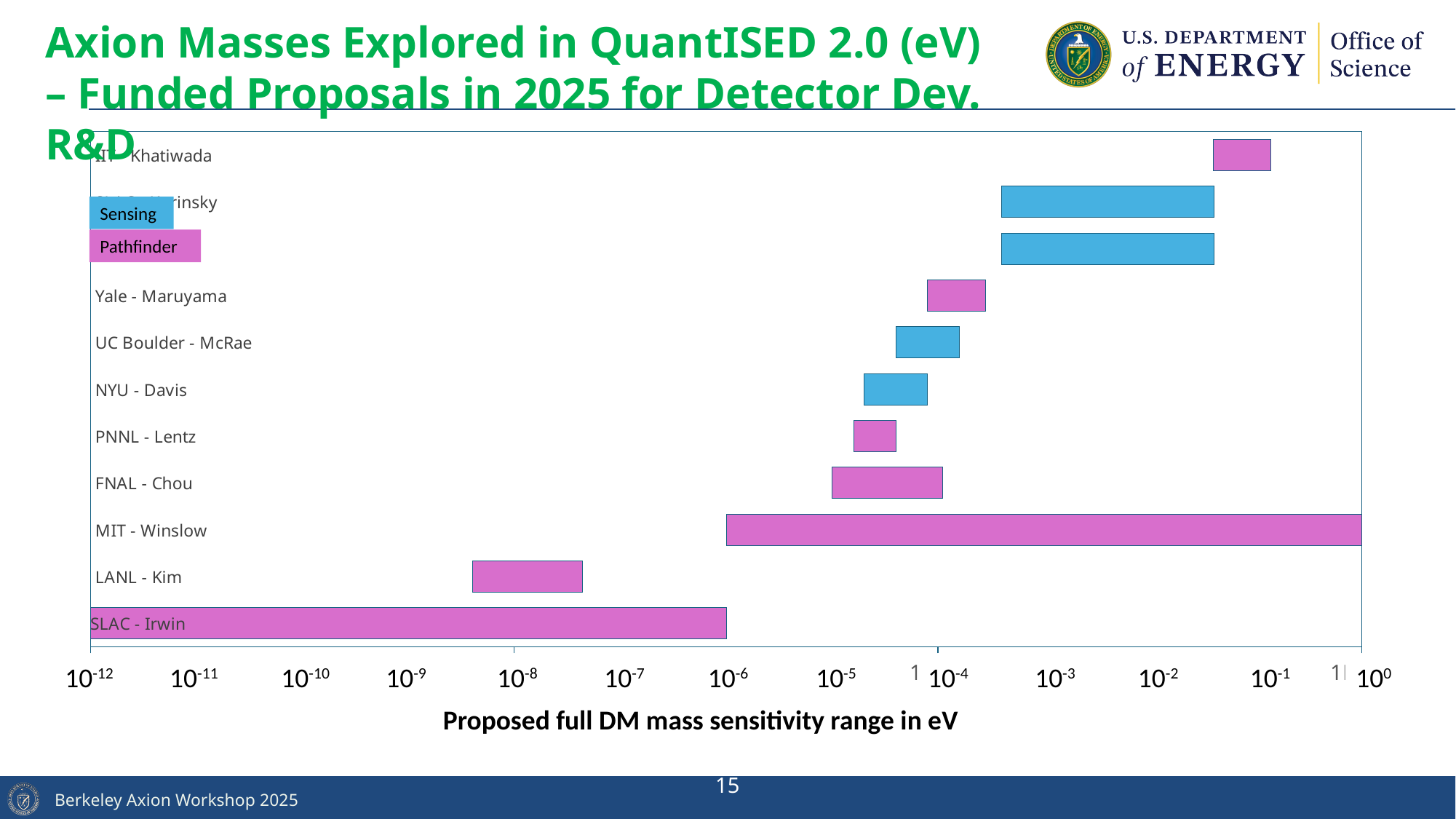
Is the lower end of the range for FNAL - Chou greater or less than 10^-6 eV? greater What kind of chart is shown on the slide? bar chart Is the upper end of the range for LANL - Kim greater or less than 10^-7 eV? less Is the lower end of the range for Yale - Maruyama greater or less than 10^-5 eV? greater How many bars are plotted in the chart? 11 How many series does the legend list? 2 Which proposal's range starts at the lowest axion mass? SLAC - Irwin Which proposal's range starts at a lower mass, LANL - Kim or FNAL - Chou? LANL - Kim What is the title of the x axis? Proposed full DM mass sensitivity range in eV Which proposal's range extends to the highest axion mass? MIT - Winslow What are the two series named in the legend? Sensing and Pathfinder